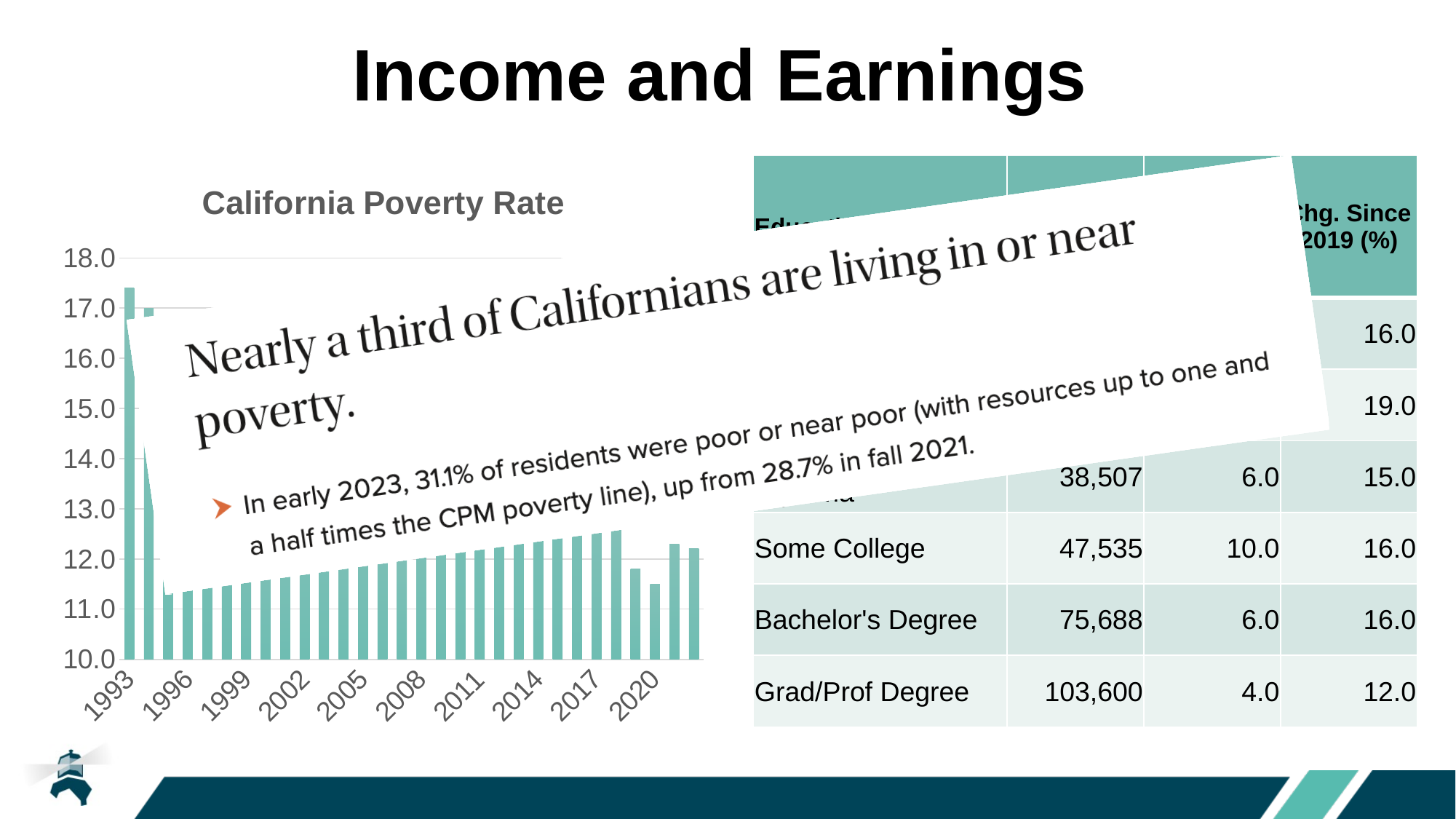
In the California Poverty Rate chart, which is larger, the value for 1993 or the value for 2020? 1993 In the California Poverty Rate chart, is the value for 1993 greater or less than 17.0? greater In the California Poverty Rate chart, what is the lowest value shown on the vertical axis? 10.0 In the California Poverty Rate chart, is the value for 2020 greater or less than 12.0? less What kind of chart is the California Poverty Rate chart? bar chart In the California Poverty Rate chart, which year has the highest bar? 1993 What is the title of the chart on the left of the slide? California Poverty Rate